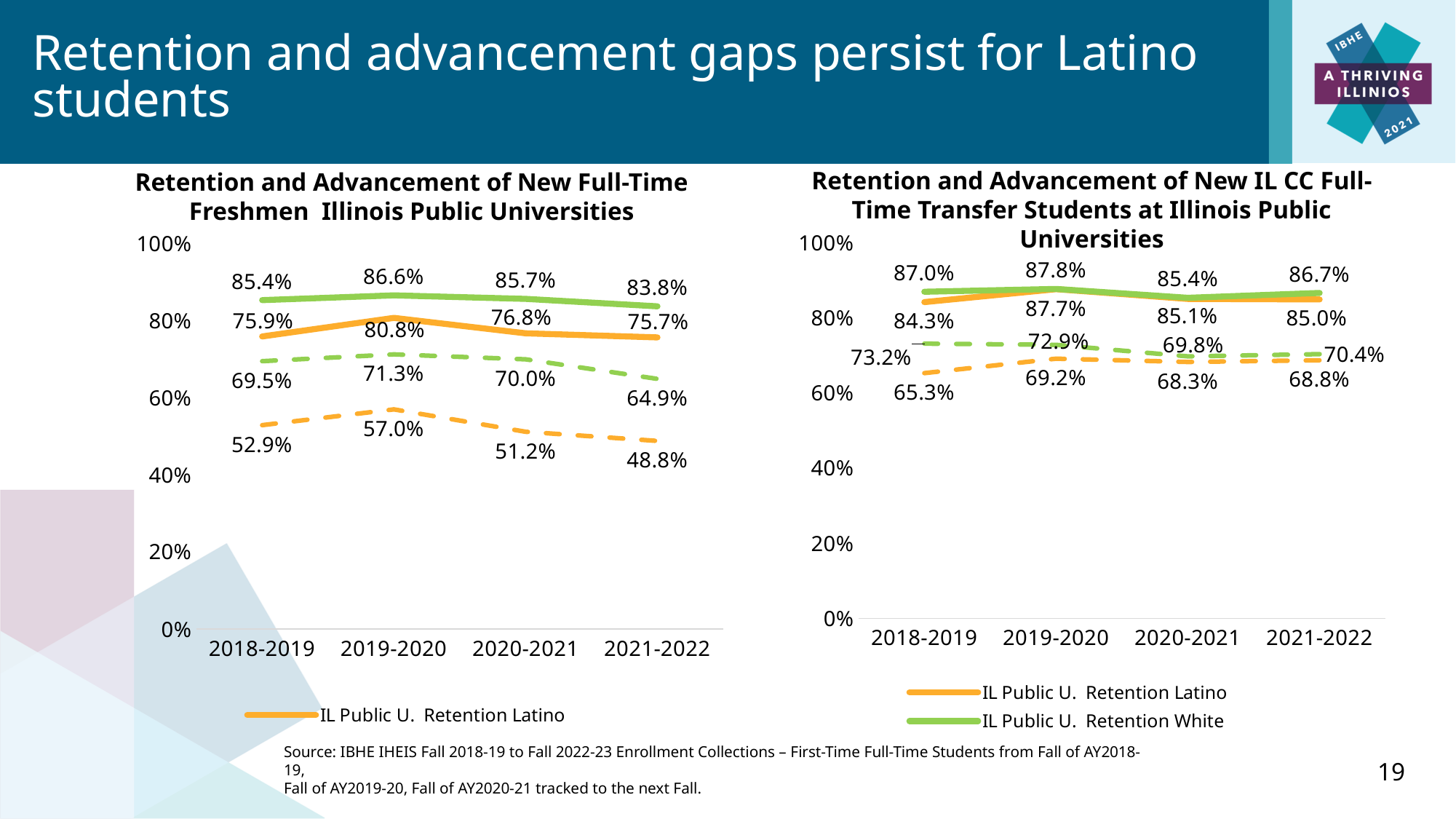
In the right chart (New IL CC Full-Time Transfer Students), is IL Public U. Retention Latino higher in 2019-2020 or 2020-2021? 2019-2020 In the right chart (New IL CC Full-Time Transfer Students), what is the IL Public U. Retention White value for 2018-2019? 87.0% In the left chart (New Full-Time Freshmen), in which year is IL Public U. Retention Latino highest? 2019-2020 What kind of chart is the left chart (New Full-Time Freshmen)? Line chart In the left chart (New Full-Time Freshmen), what is the lowest value shown on the dashed orange line? 48.8% How many academic years are shown on the x axis of the left chart (New Full-Time Freshmen)? 4 In the left chart (New Full-Time Freshmen), what is the IL Public U. Retention Latino value for 2019-2020? 80.8% In the right chart (New IL CC Full-Time Transfer Students), what is the difference between IL Public U. Retention White and IL Public U. Retention Latino in 2018-2019? 2.7 percentage points In the left chart (New Full-Time Freshmen), by how many percentage points did IL Public U. Retention Latino fall from 2019-2020 to 2021-2022? 5.1 percentage points In the right chart (New IL CC Full-Time Transfer Students), what is the IL Public U. Retention Latino value for 2021-2022? 85.0% How many series does the legend of the right chart (New IL CC Full-Time Transfer Students) list? 2 In the right chart (New IL CC Full-Time Transfer Students), in which year is IL Public U. Retention White lowest? 2020-2021